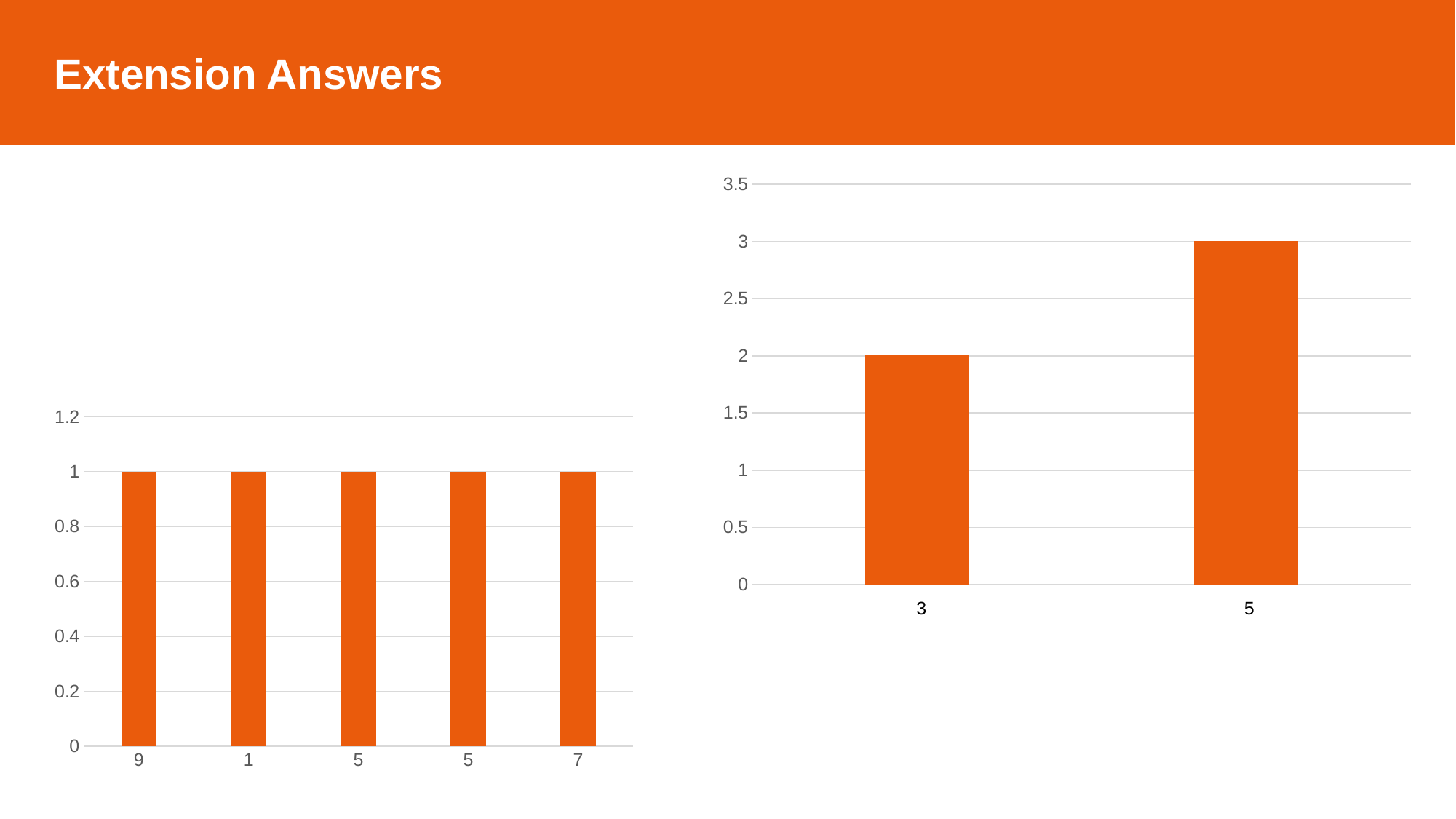
On the right chart, which category has the highest value? 5 On the left chart, what is the value for category 7? 1 On the left chart, how many bars are plotted? 5 On the right chart, is the value for category 3 greater or less than 2.5? less On the left chart, what kind of chart is shown? bar chart On the left chart, what is the value for category 9? 1 On the right chart, what is the value for category 3? 2 On the right chart, which category has the lowest value? 3 On the right chart, what is the difference between the values for category 5 and category 3? 1 On the left chart, is the value for category 1 greater or less than 1.2? less On the right chart, what is the value for category 5? 3 On the right chart, how many bars are plotted? 2